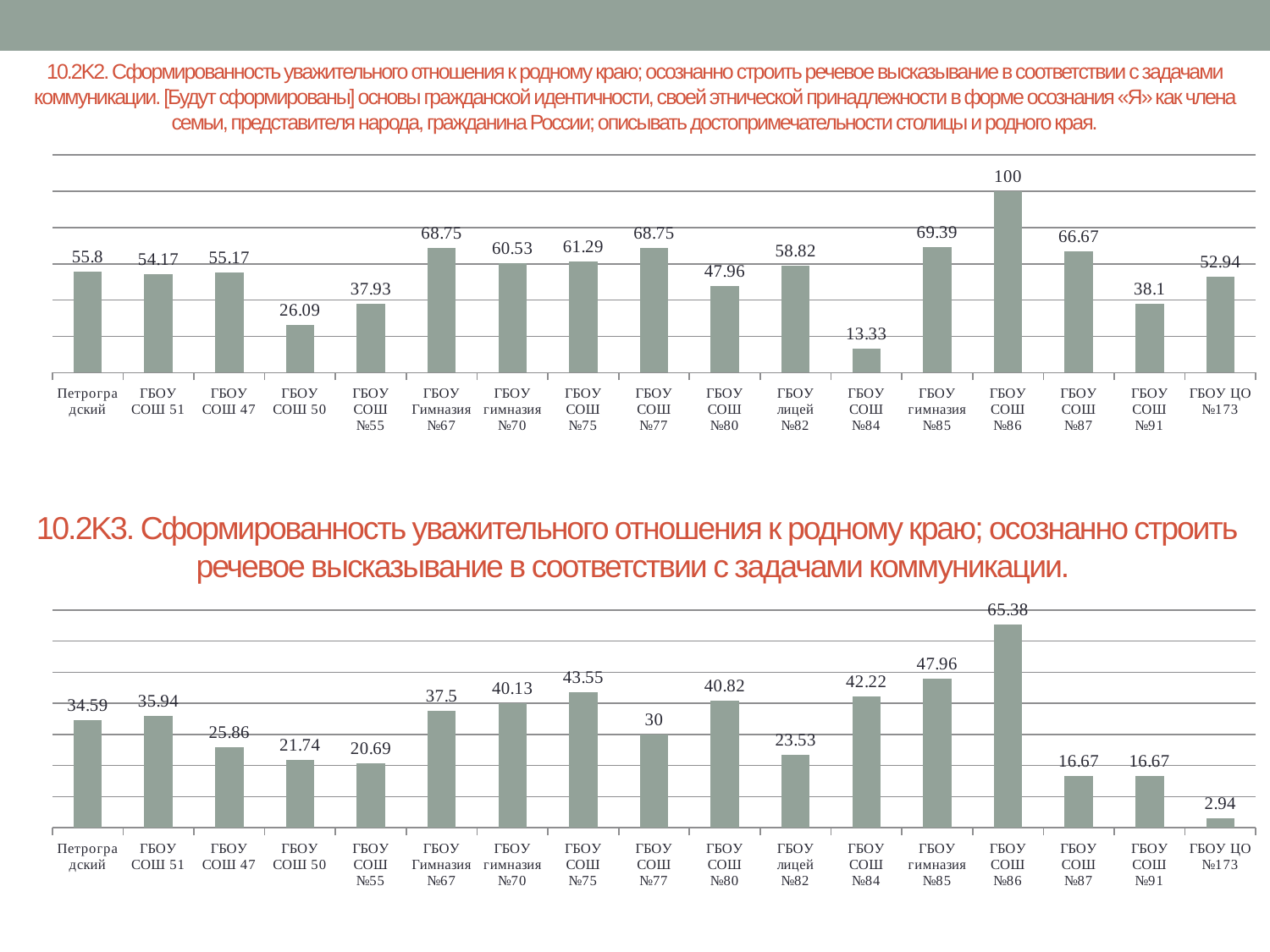
In the bottom chart (10.2К3), which school has the highest value? ГБОУ СОШ №86 What type of chart is the bottom chart (10.2К3)? bar chart In the bottom chart (10.2К3), what is the difference between the values for ГБОУ СОШ №77 and ГБОУ лицей №82? 6.47 In the bottom chart (10.2К3), what is the value for ГБОУ ЦО №173? 2.94 In the bottom chart (10.2К3), which is larger: the value for Петроградский or ГБОУ СОШ 51? ГБОУ СОШ 51 In the bottom chart (10.2К3), which school has the lowest value? ГБОУ ЦО №173 In the top chart (10.2К2), which school has the lowest value? ГБОУ СОШ №84 How many schools (categories) are shown in the top chart (10.2К2)? 17 In the top chart (10.2К2), what is the difference between the values for ГБОУ СОШ №86 and ГБОУ гимназия №85? 30.61 In the top chart (10.2К2), which school has the highest value? ГБОУ СОШ №86 In the top chart (10.2К2), what is the value for ГБОУ СОШ №84? 13.33 In the top chart (10.2К2), which is larger: the value for ГБОУ СОШ №75 or ГБОУ гимназия №70? ГБОУ СОШ №75